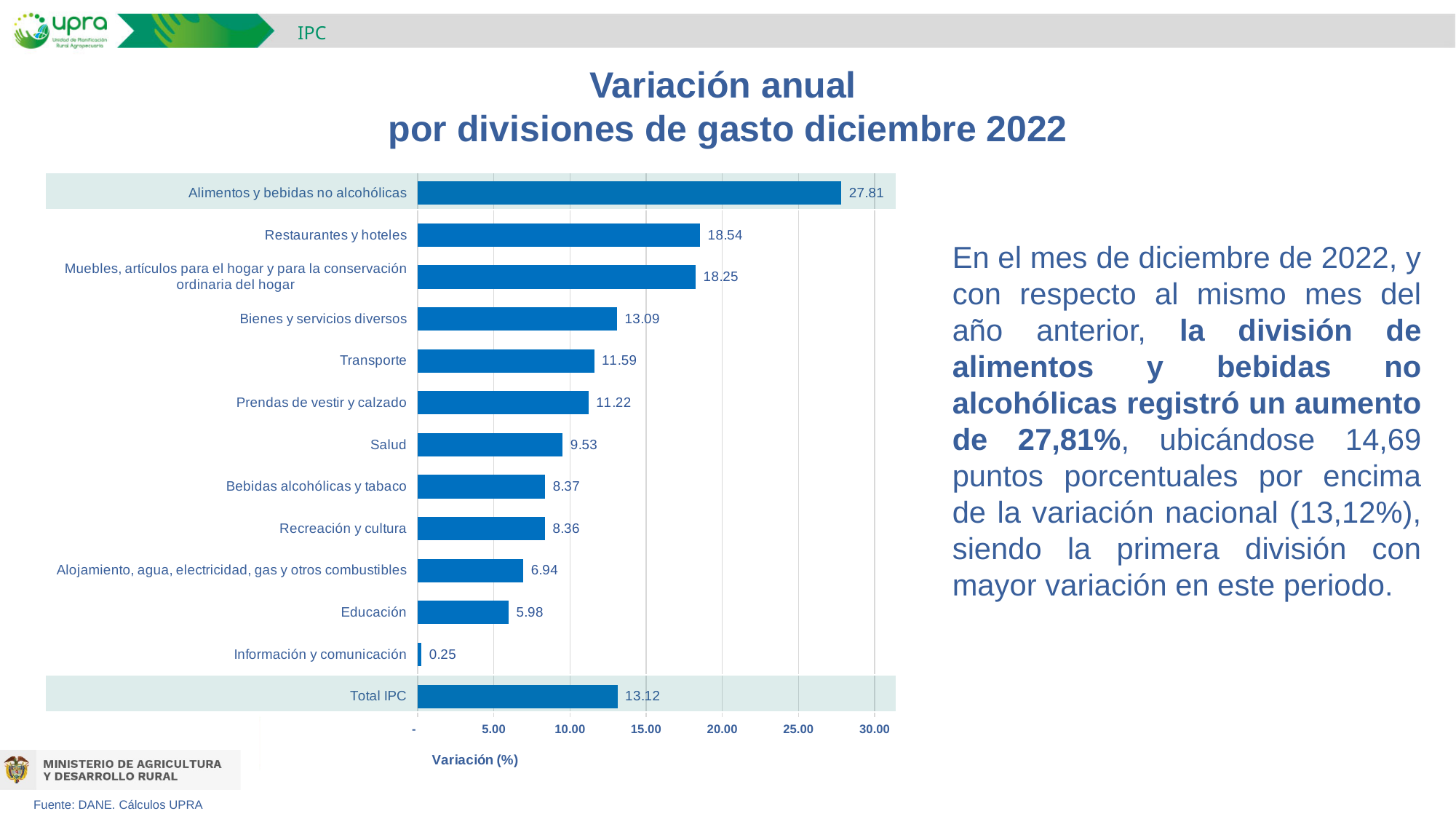
Which category has the highest value? Alimentos y bebidas no alcohólicas What is the value for Transporte? 11.59 What is the difference between Restaurantes y hoteles and Salud? 9.01 How many categories are shown in the chart? 13 What is the label of the x axis? Variación (%) What is the value for Educación? 5.98 Which category has the lowest value? Información y comunicación What kind of chart is shown? Bar chart What is the value for Total IPC? 13.12 Which is larger, Bienes y servicios diversos or Prendas de vestir y calzado? Bienes y servicios diversos Is the value for Alojamiento, agua, electricidad, gas y otros combustibles greater or less than 10.00? less What is the value for Alimentos y bebidas no alcohólicas? 27.81